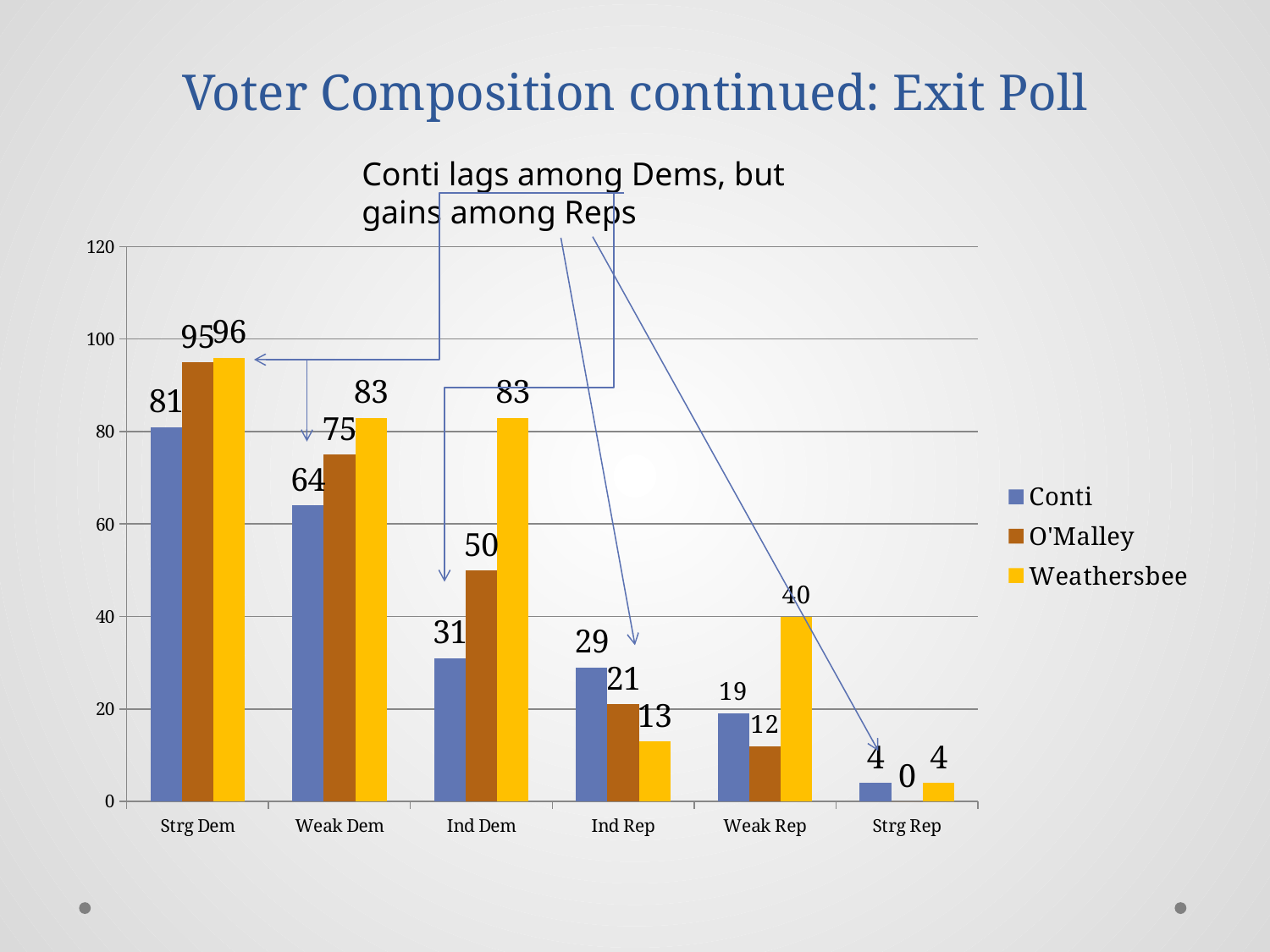
What is the value for O'Malley in the Weak Rep category? 12 What kind of chart is shown on the slide? bar chart Is the value for O'Malley in the Ind Dem category greater or less than 40? greater Do the values for Conti rise or fall from Strg Dem to Strg Rep along the x axis? fall Which category has the highest value for Conti? Strg Dem Which category has the lowest value for O'Malley? Strg Rep How many categories are shown on the x axis? 6 How many series does the legend list? 3 What is the value for Weathersbee in the Ind Dem category? 83 What is the value for Conti in the Strg Dem category? 81 In the Ind Rep category, which is larger: the value for Conti or the value for Weathersbee? Conti What is the difference between the Weathersbee and Conti values in the Weak Rep category? 21